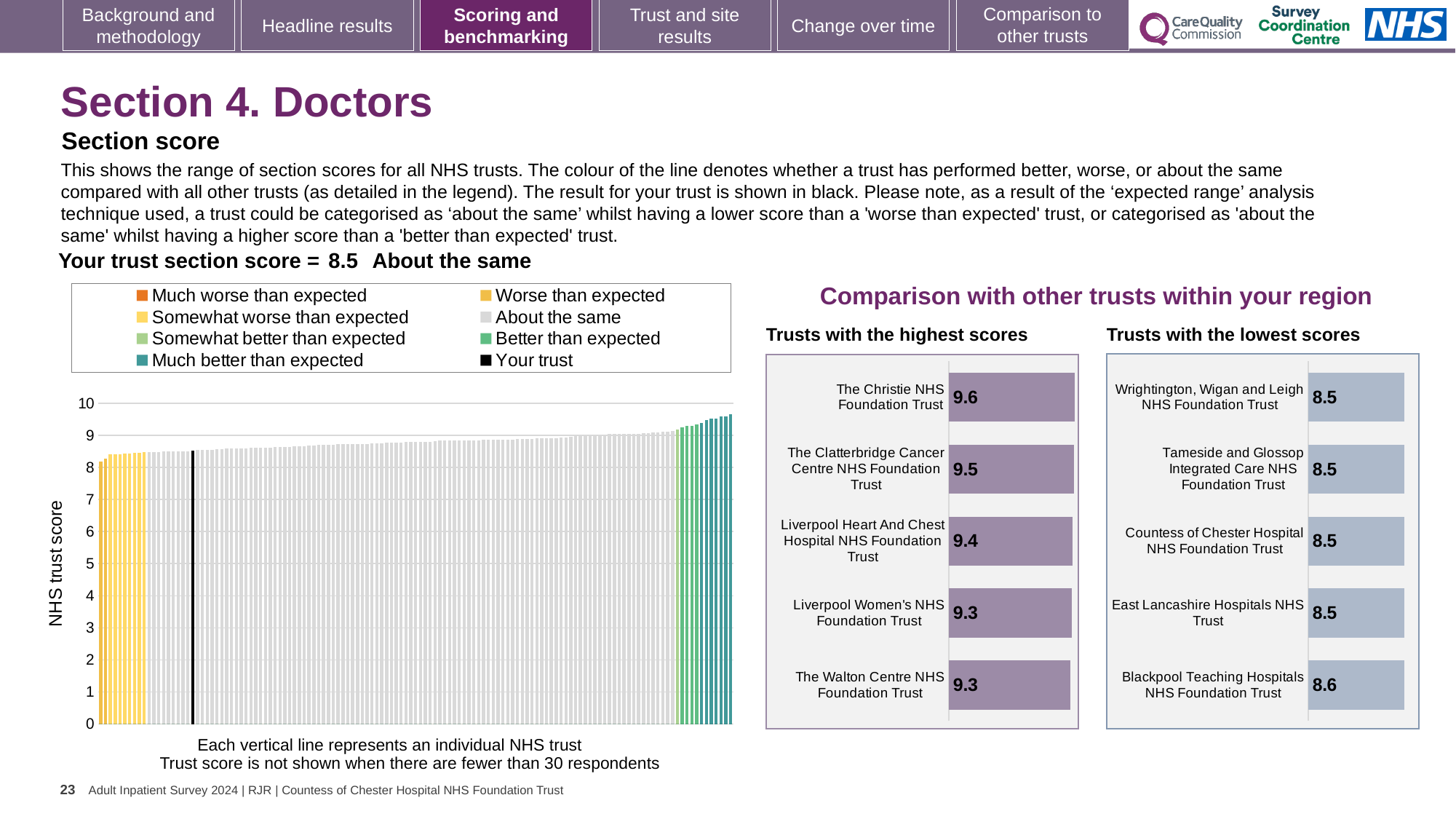
In the 'Trusts with the lowest scores' chart, which trust has the highest score? Blackpool Teaching Hospitals NHS Foundation Trust In the large chart on the left showing NHS trust scores, do the values rise or fall from left to right along the x axis? Rise In the 'Trusts with the highest scores' chart, what is the score for The Christie NHS Foundation Trust? 9.6 In the large chart on the left showing NHS trust scores, what kind of chart is it? Bar chart In the 'Trusts with the lowest scores' chart, what is the score for Countess of Chester Hospital NHS Foundation Trust? 8.5 In the 'Trusts with the lowest scores' chart, what is the score for Blackpool Teaching Hospitals NHS Foundation Trust? 8.6 In the 'Trusts with the highest scores' chart, what is the difference between the scores of The Christie NHS Foundation Trust and The Walton Centre NHS Foundation Trust? 0.3 How many entries does the legend of the large chart on the left list? 8 In the 'Trusts with the highest scores' chart, which trust has the highest score? The Christie NHS Foundation Trust In the 'Trusts with the lowest scores' chart, what is the difference between the scores of Blackpool Teaching Hospitals NHS Foundation Trust and Wrightington, Wigan and Leigh NHS Foundation Trust? 0.1 In the 'Trusts with the highest scores' chart, what is the score for Liverpool Heart And Chest Hospital NHS Foundation Trust? 9.4 How many trusts are listed in the 'Trusts with the highest scores' chart? 5